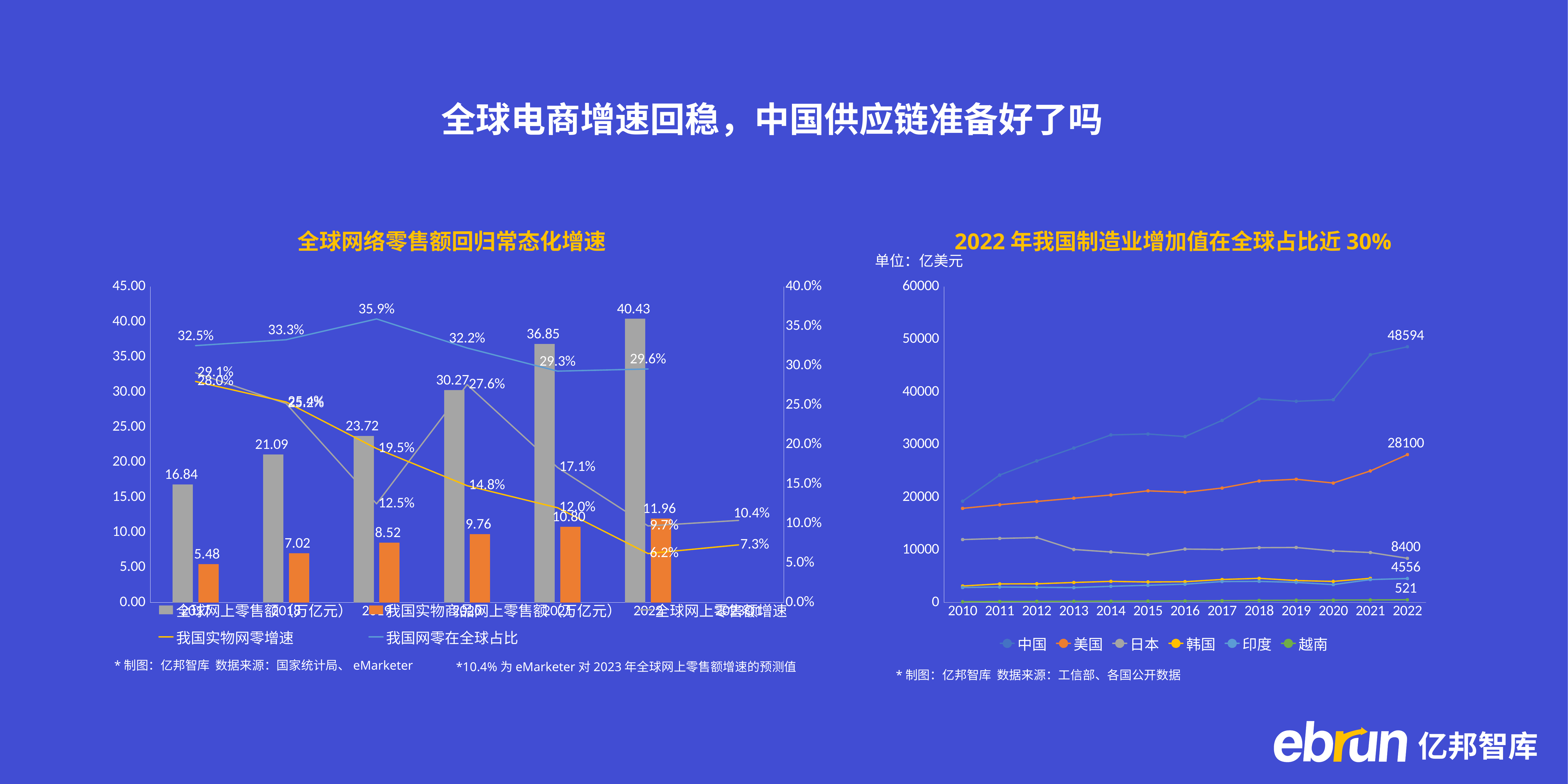
In the right-hand chart, which country has the highest value in 2022? 中国 In the left-hand chart, what is the highest value shown for the 我国网零在全球占比 line? 35.9% How many series does the legend of the right-hand chart list? 6 In the right-hand chart, what is the value for 中国 in 2022? 48594 In the right-hand chart, how many years are shown on the x axis? 13 In the left-hand chart, what is the value of the tallest grey bar (全球网上零售额)? 40.43 In the right-hand chart, what is the value for 日本 in 2022? 8400 In the right-hand chart, what is the value for 美国 in 2022? 28100 In the right-hand chart, what is the difference between the 2022 values for 中国 and 美国? 20494 What kind of chart is the right-hand chart titled "2022 年我国制造业增加值在全球占比近 30%"? line chart In the right-hand chart, is the value for 中国 in 2018 greater or less than 30000? greater In the right-hand chart, what is the value for 越南 in 2022? 521